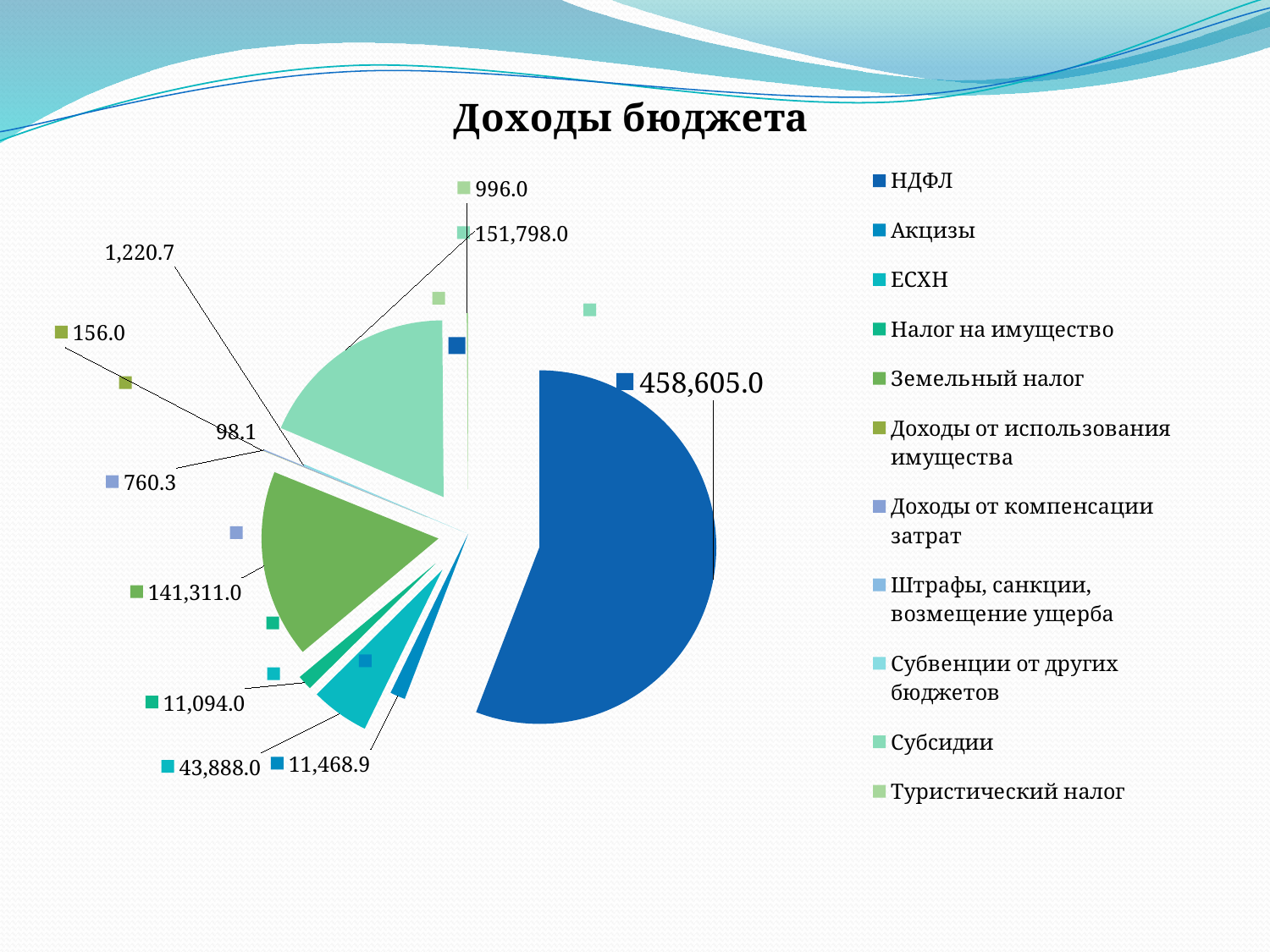
What is the value for Земельный налог? 141,311.0 What is the value for Туристический налог? 996.0 What is the value for ЕСХН? 43,888.0 What is the value for НДФЛ? 458,605.0 What is the title of the chart? Доходы бюджета What is the value for Субвенции от других бюджетов? 1,220.7 Which category has the largest slice of the pie? НДФЛ How many categories does the legend list? 11 What kind of chart is shown on the slide? pie chart What is the value for Акцизы? 11,468.9 Which is larger: Субвенции от других бюджетов or Земельный налог? Земельный налог What is the difference between the values for НДФЛ and Земельный налог? 317,294.0